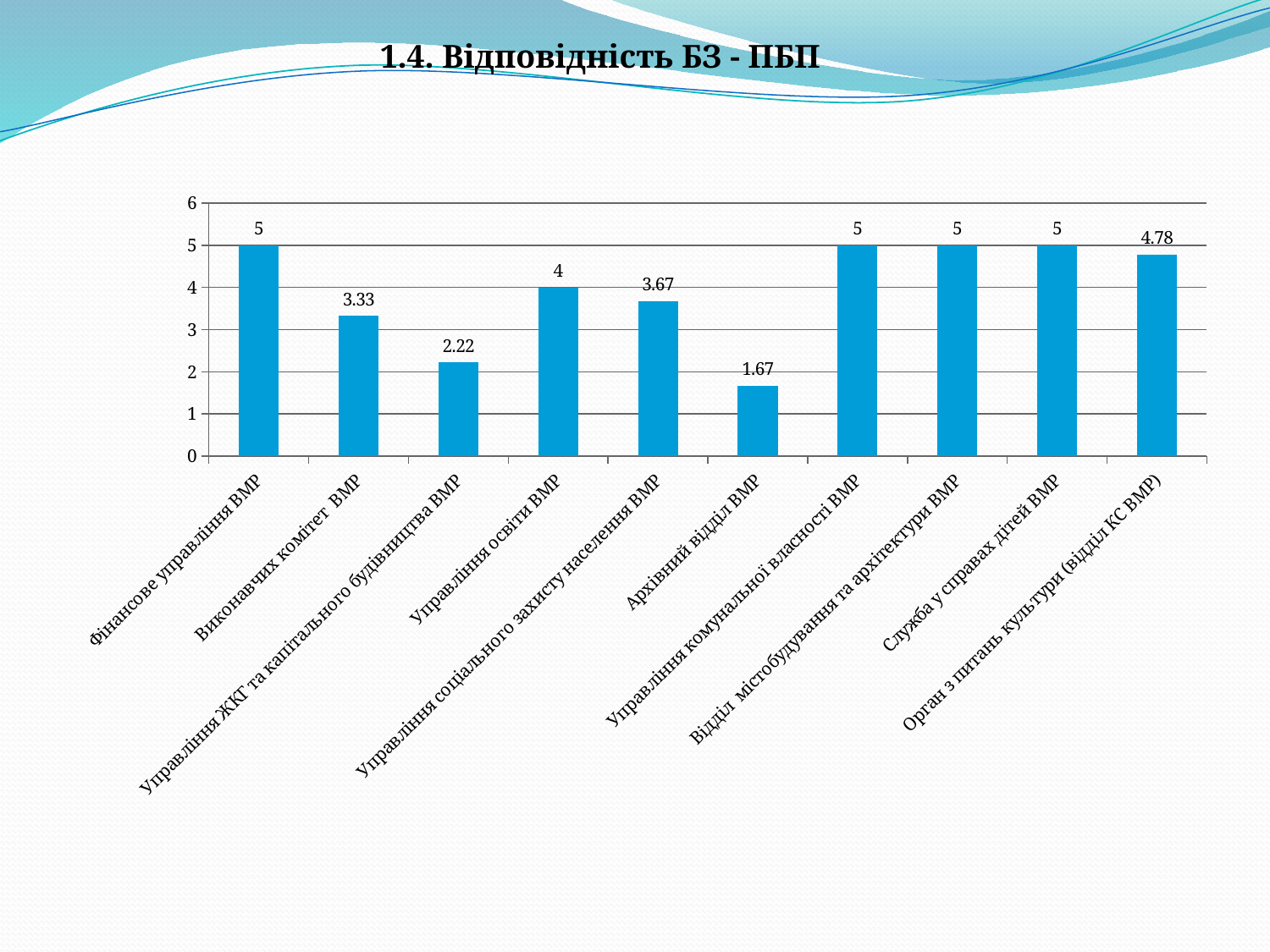
Is the value for Управління ЖКГ та капітального будівництва ВМР greater or less than 3? less What is the value for Управління соціального захисту населення ВМР? 3.67 What is the title of the slide? 1.4. Відповідність БЗ - ПБП What is the difference between the values for Управління освіти ВМР and Архівний відділ ВМР? 2.33 What is the value for Управління ЖКГ та капітального будівництва ВМР? 2.22 How many categories are shown on the chart? 10 What is the value for Орган з питань культури (відділ КС ВМР)? 4.78 Which category has the lowest value? Архівний відділ ВМР Which is larger, the value for Виконавчих комітет ВМР or the value for Управління соціального захисту населення ВМР? Управління соціального захисту населення ВМР What is the value for Виконавчих комітет ВМР? 3.33 What is the difference between the values for Фінансове управління ВМР and Орган з питань культури (відділ КС ВМР)? 0.22 What kind of chart is shown on the slide? bar chart